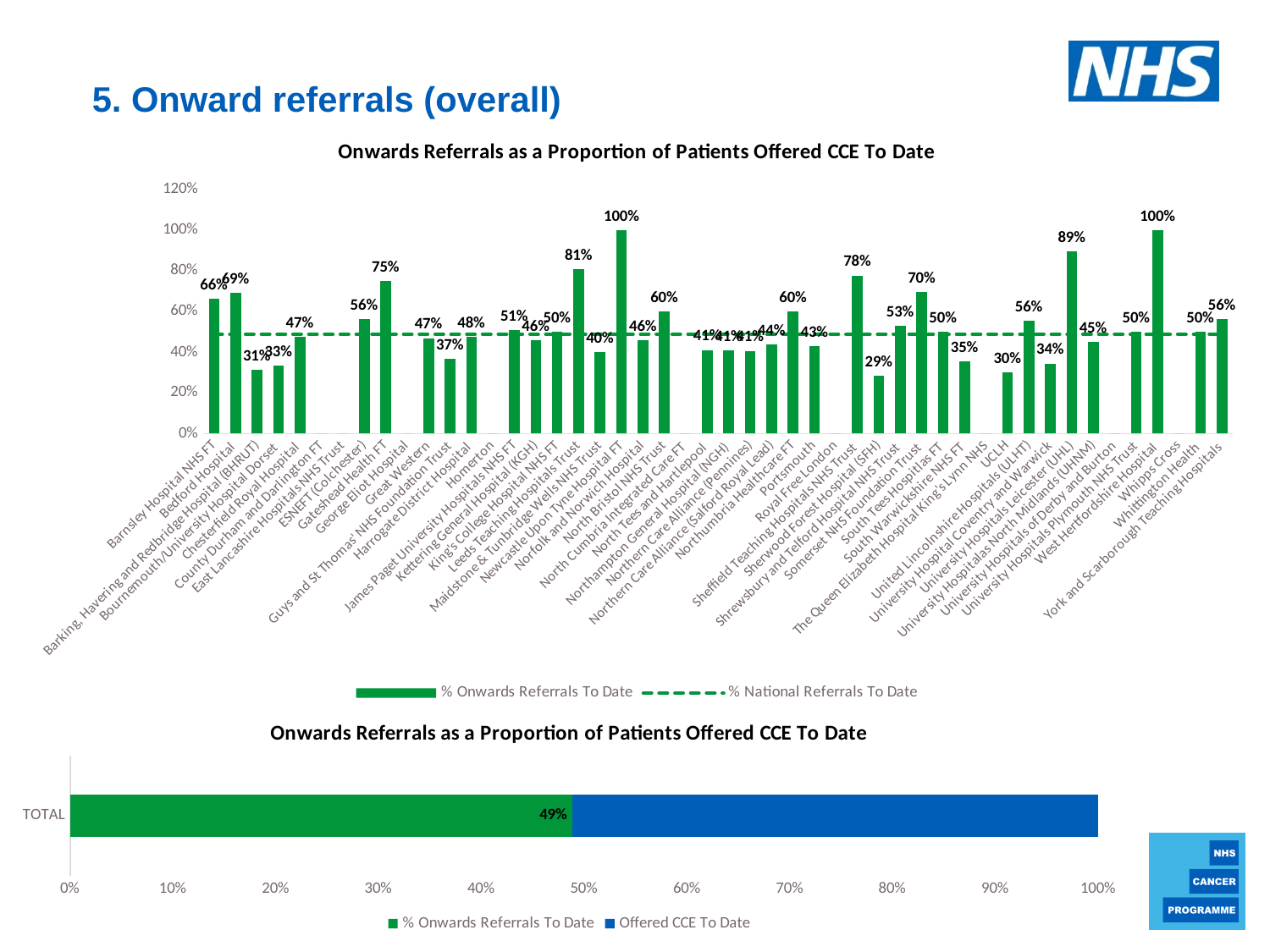
In the top chart, which has the larger value: Sheffield Teaching Hospitals NHS Trust or Somerset NHS Foundation Trust? Sheffield Teaching Hospitals NHS Trust In the bottom chart, what is the '% Onwards Referrals To Date' value for TOTAL? 49% What kind of chart is the bottom chart on the slide? bar chart In the top chart, what is the value for Gateshead Health FT? 75% In the top chart, what is the difference between the values for Newcastle Upon Tyne Hospital FT and Leeds Teaching Hospitals Trust? 19% In the top chart, what is the value for Barnsley Hospital NHS FT? 66% In the top chart, what is the value for Leeds Teaching Hospitals Trust? 81% How many series does the legend of the top chart list? 2 What kind of chart is the top chart, 'Onwards Referrals as a Proportion of Patients Offered CCE To Date'? bar chart In the top chart, what is the lowest value shown on any bar? 29% In the top chart, what is the highest value shown on any bar? 100% In the top chart, what is the value for Newcastle Upon Tyne Hospital FT? 100%